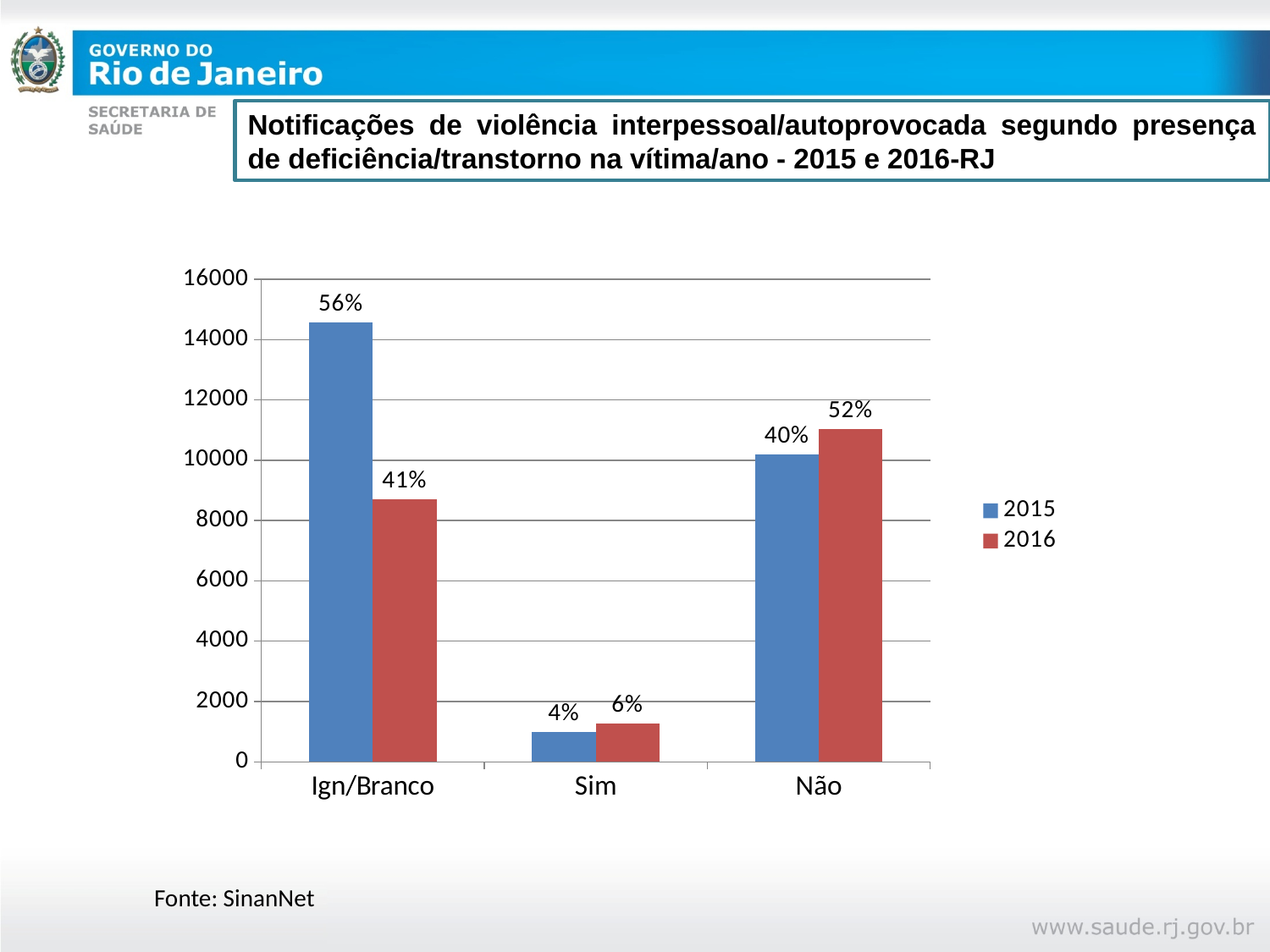
Which category has the tallest bar for 2015? Ign/Branco How many series does the legend list? 2 What percentage label is shown on the 2016 bar for Ign/Branco? 41% How many categories are shown on the x axis? 3 What kind of chart is shown on the slide? bar chart Is the 2016 bar for Sim greater or less than 2000? less What percentage label is shown on the 2015 bar for Sim? 4% For Não, which year has the taller bar, 2015 or 2016? 2016 Is the 2015 bar for Ign/Branco greater or less than 14000? greater Which category has the shortest bar for 2016? Sim What percentage label is shown on the 2015 bar for Ign/Branco? 56% What percentage label is shown on the 2016 bar for Não? 52%